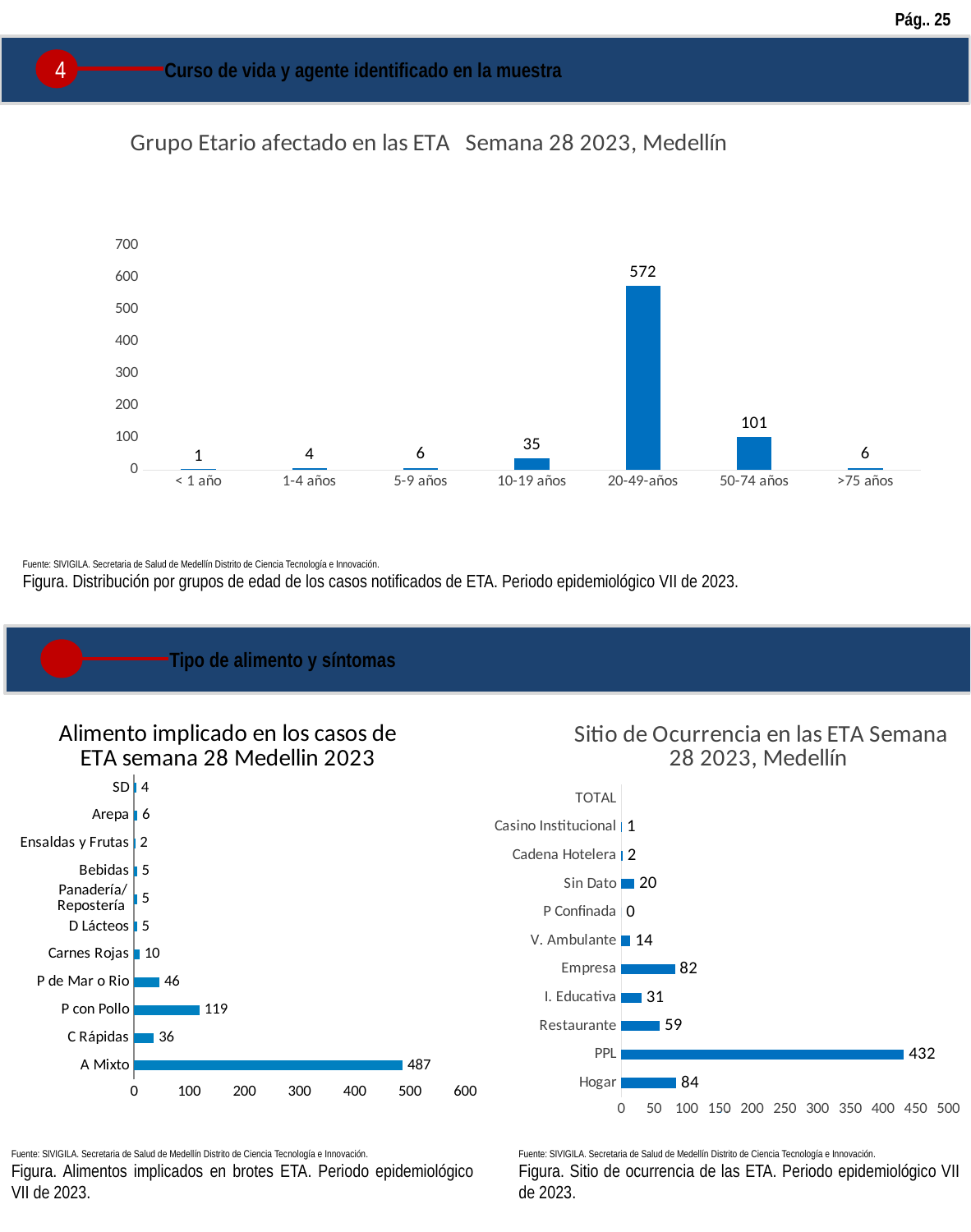
In the 'Sitio de Ocurrencia en las ETA' chart, which is larger: Restaurante or I. Educativa? Restaurante How many age groups are shown in the 'Grupo Etario afectado en las ETA' chart? 7 In the 'Grupo Etario afectado en las ETA' chart, which age group has the lowest value? < 1 año In the 'Grupo Etario afectado en las ETA' chart, what is the value for 20-49-años? 572 In the 'Grupo Etario afectado en las ETA' chart, what is the difference between the values for 50-74 años and 10-19 años? 66 How many food categories are listed in the 'Alimento implicado en los casos de ETA' chart? 11 In the 'Alimento implicado en los casos de ETA' chart, which food category has the highest value? A Mixto In the 'Alimento implicado en los casos de ETA' chart, which is larger: P de Mar o Rio or C Rápidas? P de Mar o Rio In the 'Alimento implicado en los casos de ETA' chart, what is the value for P con Pollo? 119 What type of chart is the 'Grupo Etario afectado en las ETA' chart? Bar chart In the 'Sitio de Ocurrencia en las ETA' chart, what is the difference between the values for Hogar and Empresa? 2 In the 'Sitio de Ocurrencia en las ETA' chart, what is the value for PPL? 432